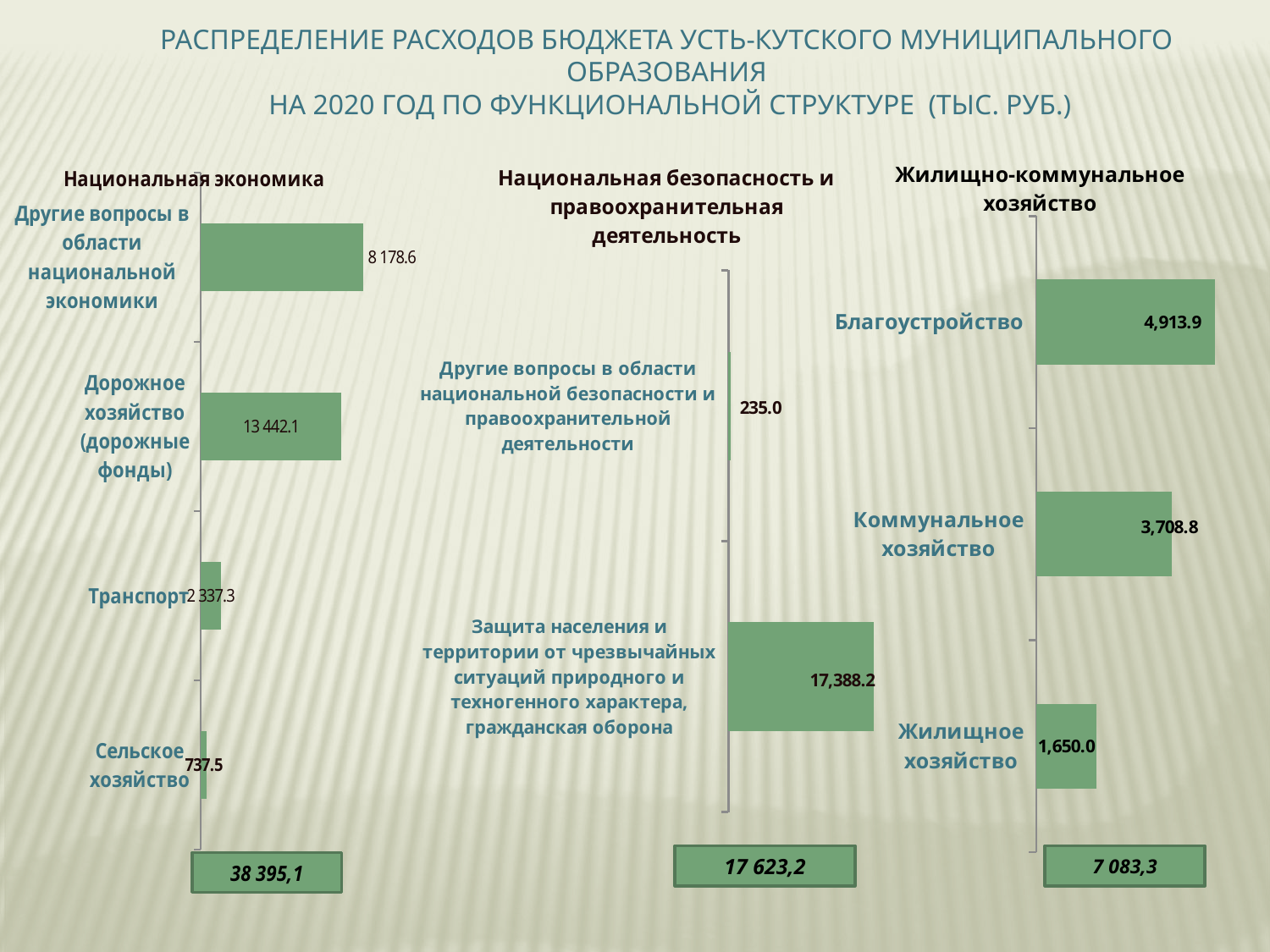
In the 'Национальная экономика' chart, what is the value for 'Дорожное хозяйство (дорожные фонды)'? 13 442.1 In the 'Национальная безопасность и правоохранительная деятельность' chart, what is the value for 'Защита населения и территории от чрезвычайных ситуаций природного и техногенного характера, гражданская оборона'? 17,388.2 In the 'Национальная экономика' chart, which category has the lowest value? Сельское хозяйство In the 'Жилищно-коммунальное хозяйство' chart, what is the difference between 'Благоустройство' and 'Коммунальное хозяйство'? 1,205.1 In the 'Жилищно-коммунальное хозяйство' chart, what is the value for 'Коммунальное хозяйство'? 3,708.8 In the 'Жилищно-коммунальное хозяйство' chart, which is larger: 'Благоустройство' or 'Жилищное хозяйство'? Благоустройство In the 'Национальная экономика' chart, what is the value for 'Сельское хозяйство'? 737.5 In the 'Национальная безопасность и правоохранительная деятельность' chart, what is the difference between the two plotted values? 17,153.2 In the 'Национальная экономика' chart, how many categories are shown? 4 In the 'Национальная безопасность и правоохранительная деятельность' chart, what is the value for 'Другие вопросы в области национальной безопасности и правоохранительной деятельности'? 235.0 What type of chart is used for 'Жилищно-коммунальное хозяйство'? Bar chart